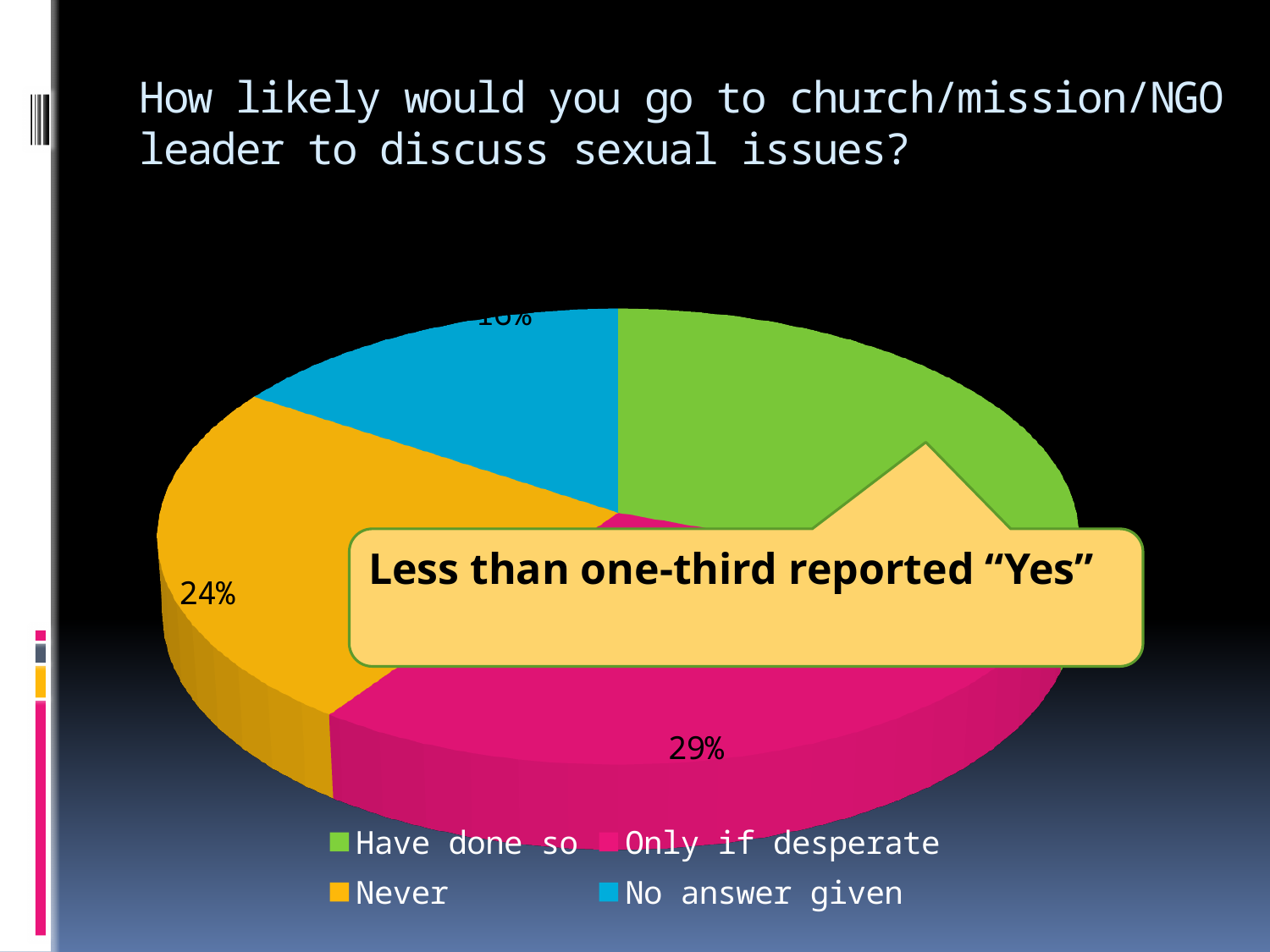
Which is larger, the share for "Never" or the share for "Only if desperate"? Only if desperate What percentage of respondents answered "Never"? 24% What kind of chart is shown on the slide? Pie chart Which category has the smallest slice of the pie? No answer given How many categories does the pie chart show? 4 What percentage of respondents answered "Only if desperate"? 29% What does the callout box over the chart say? Less than one-third reported "Yes" What question does the chart title ask? How likely would you go to church/mission/NGO leader to discuss sexual issues? What is the difference in percentage points between "Only if desperate" and "Never"? 5%